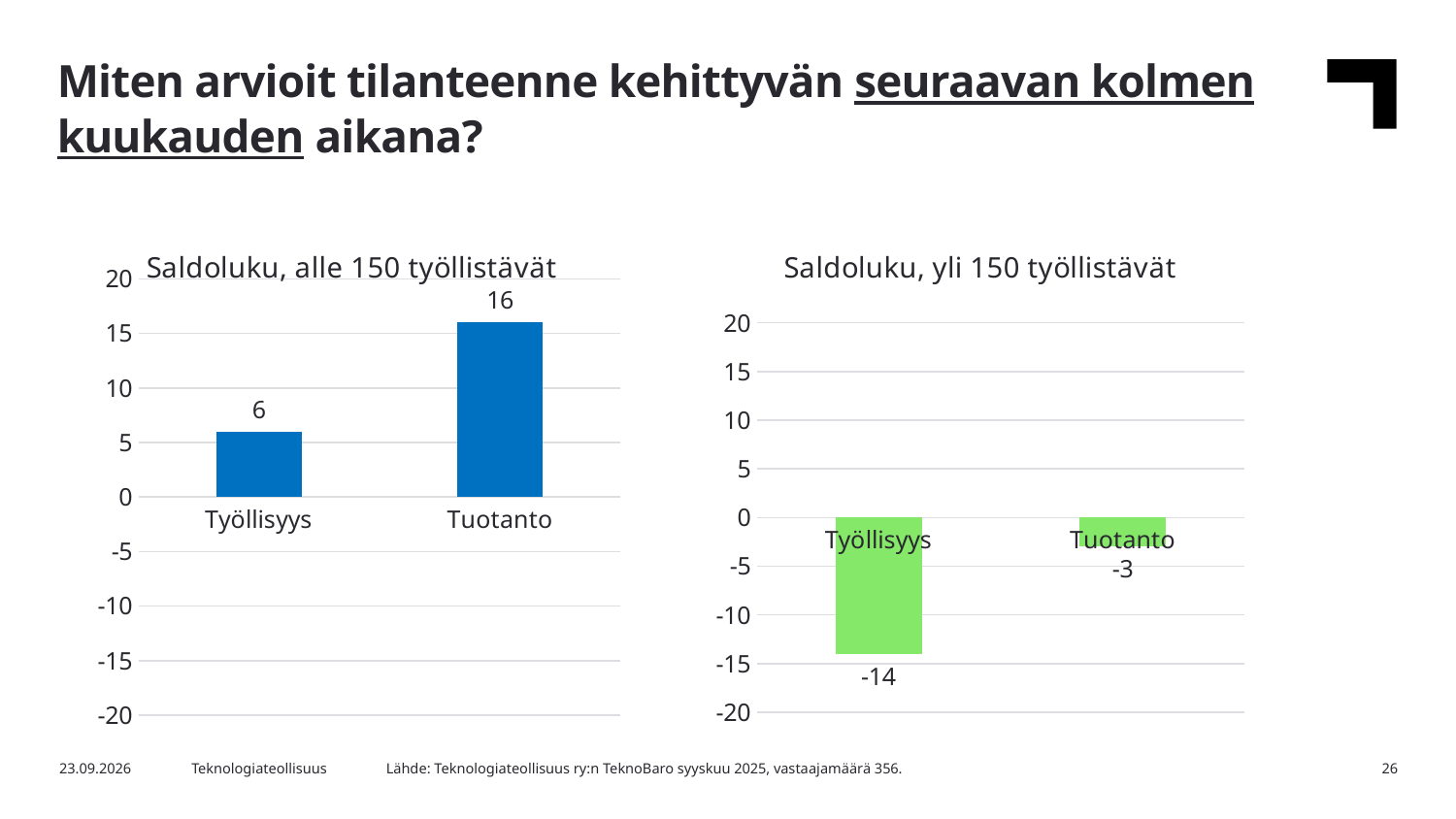
How many categories are shown in the chart titled 'Saldoluku, alle 150 työllistävät'? 2 In the chart titled 'Saldoluku, yli 150 työllistävät', what is the difference between the values for Tuotanto and Työllisyys? 11 In the chart titled 'Saldoluku, alle 150 työllistävät', which category has the highest value? Tuotanto In the chart titled 'Saldoluku, yli 150 työllistävät', what is the value for Tuotanto? -3 In the chart titled 'Saldoluku, alle 150 työllistävät', what is the value for Työllisyys? 6 In the chart titled 'Saldoluku, alle 150 työllistävät', what is the value for Tuotanto? 16 In the chart titled 'Saldoluku, yli 150 työllistävät', which is larger, the value for Työllisyys or Tuotanto? Tuotanto What colour are the bars in the chart titled 'Saldoluku, yli 150 työllistävät'? Green In the chart titled 'Saldoluku, yli 150 työllistävät', what is the value for Työllisyys? -14 In the chart titled 'Saldoluku, alle 150 työllistävät', what is the difference between the values for Tuotanto and Työllisyys? 10 What kind of chart is the chart titled 'Saldoluku, yli 150 työllistävät'? Bar chart In the chart titled 'Saldoluku, yli 150 työllistävät', which category has the lowest value? Työllisyys